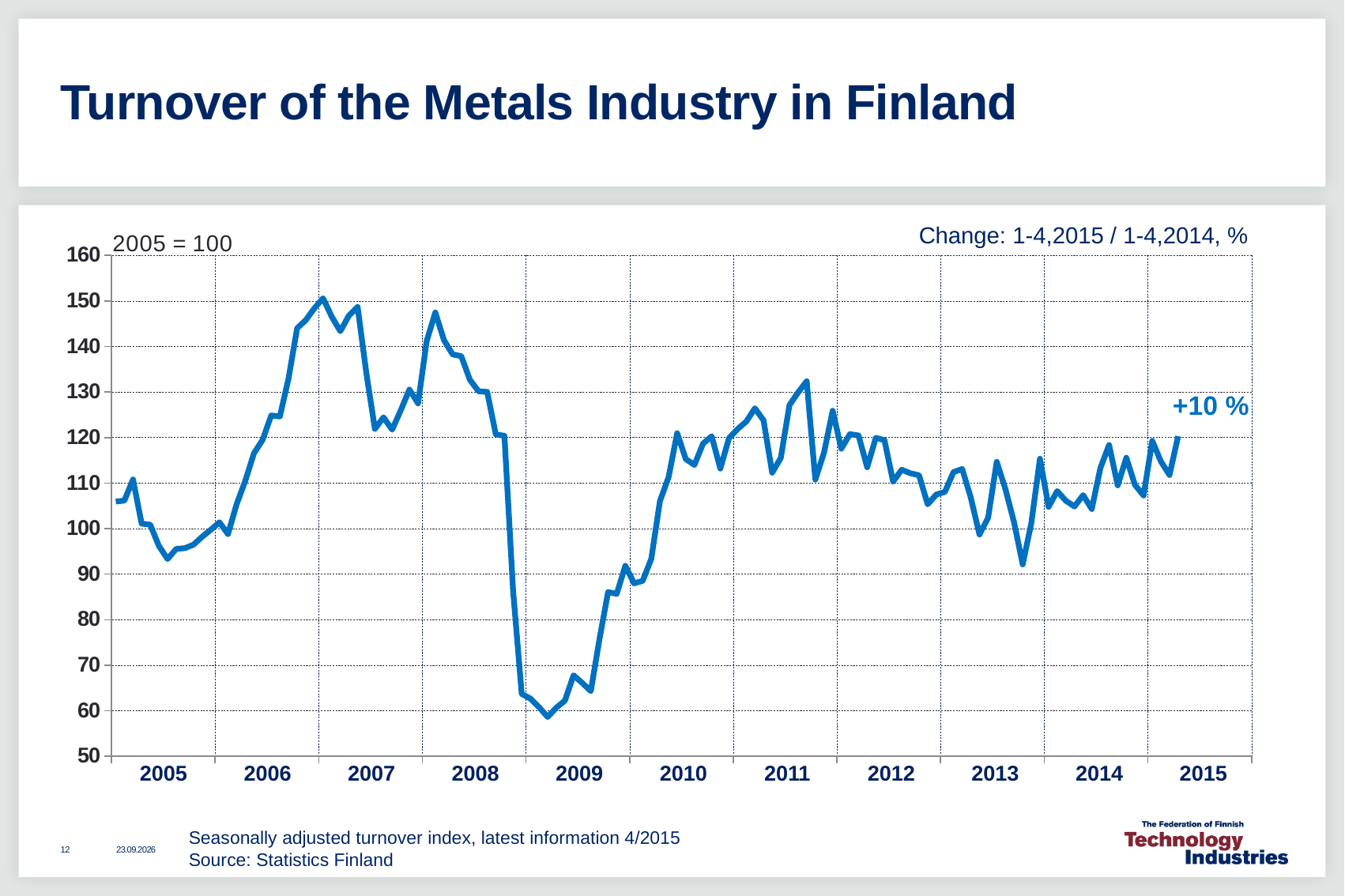
Is the index value at the start of 2009 greater or less than 70? less Which year is used as the base year (= 100) for the index? 2005 Does the index rise or fall between the start of 2009 and the start of 2010? rise In which year does the index reach its highest point? 2007 What is the percentage change shown for 1-4,2015 compared with 1-4,2014? +10 % Does the index rise or fall between mid-2008 and the start of 2009? fall Is the index value at the start of 2005 greater or less than 100? greater What is the title of the chart on the slide? Turnover of the Metals Industry in Finland How many year labels are shown on the x axis? 11 In which year does the index reach its lowest point? 2009 What kind of chart is shown on the slide? line chart Is the highest index value in 2011 greater or less than 120? greater